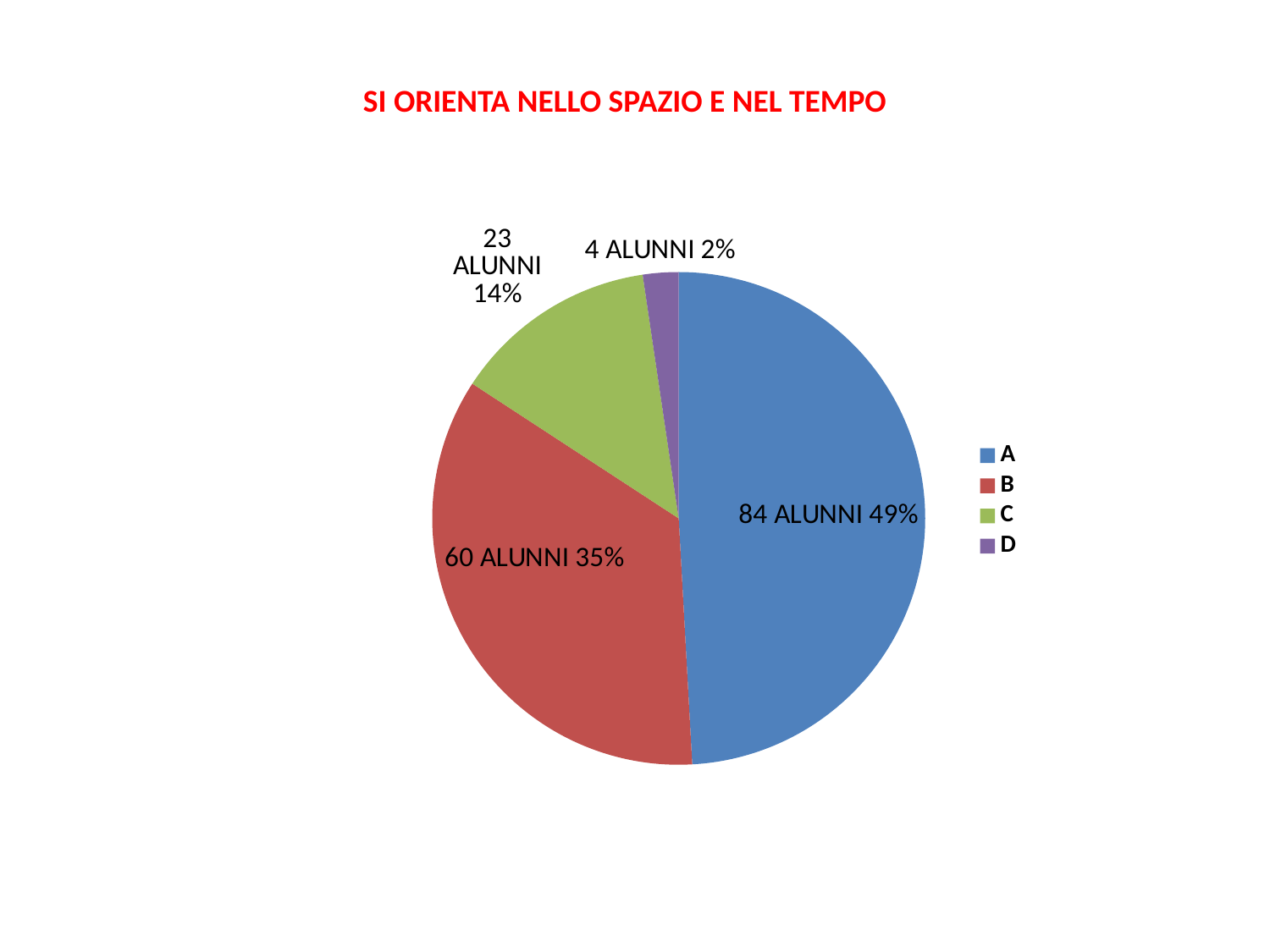
What share of the pie does category B represent? 35% How many alunni are in category D? 4 ALUNNI How many slices does the pie chart have? 4 What is the title of the chart? SI ORIENTA NELLO SPAZIO E NEL TEMPO Which category has the smallest slice? D Which category has the largest slice? A What share of the pie does category A represent? 49% How many categories does the legend list? 4 What kind of chart is shown on the slide? Pie chart What share of the pie does category C represent? 14% How many alunni are in category B? 60 ALUNNI What is the difference in number of alunni between category A and category C? 61